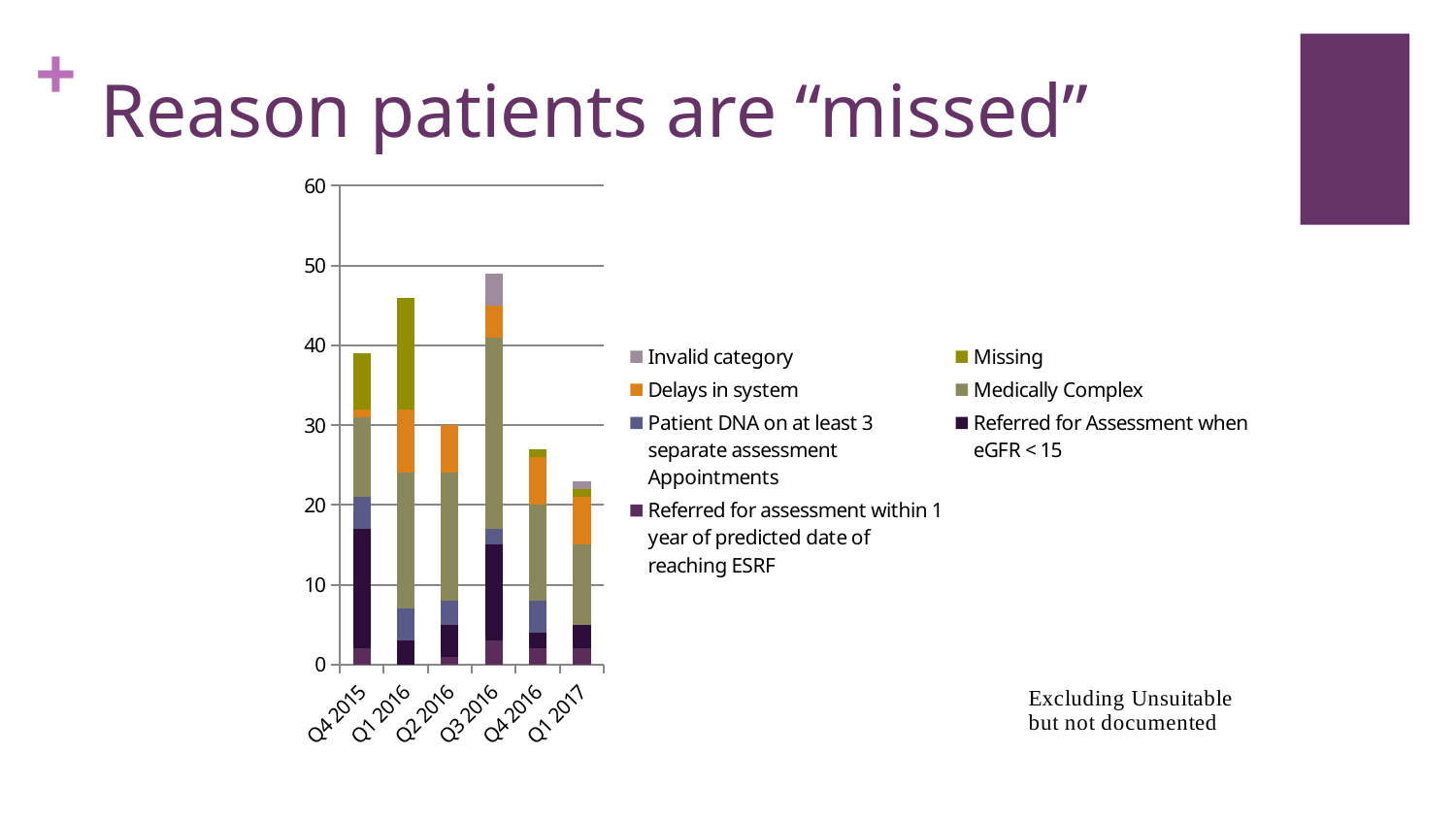
Which quarter has the tallest stacked bar? Q3 2016 What kind of chart is shown on the slide? Stacked bar chart Is the total height of the bar for Q4 2015 greater or less than 30? greater Which quarter has the shortest stacked bar? Q1 2017 Which bar is taller in total, Q1 2016 or Q2 2016? Q1 2016 Is the total height of the bar for Q2 2016 greater or less than 40? less How many quarters are shown along the x axis of the chart? 6 Is the total height of the bar for Q4 2016 greater or less than 30? less Which legend series is shown in orange? Delays in system How many series does the chart's legend list? 7 What is the title of the slide containing the chart? Reason patients are "missed"